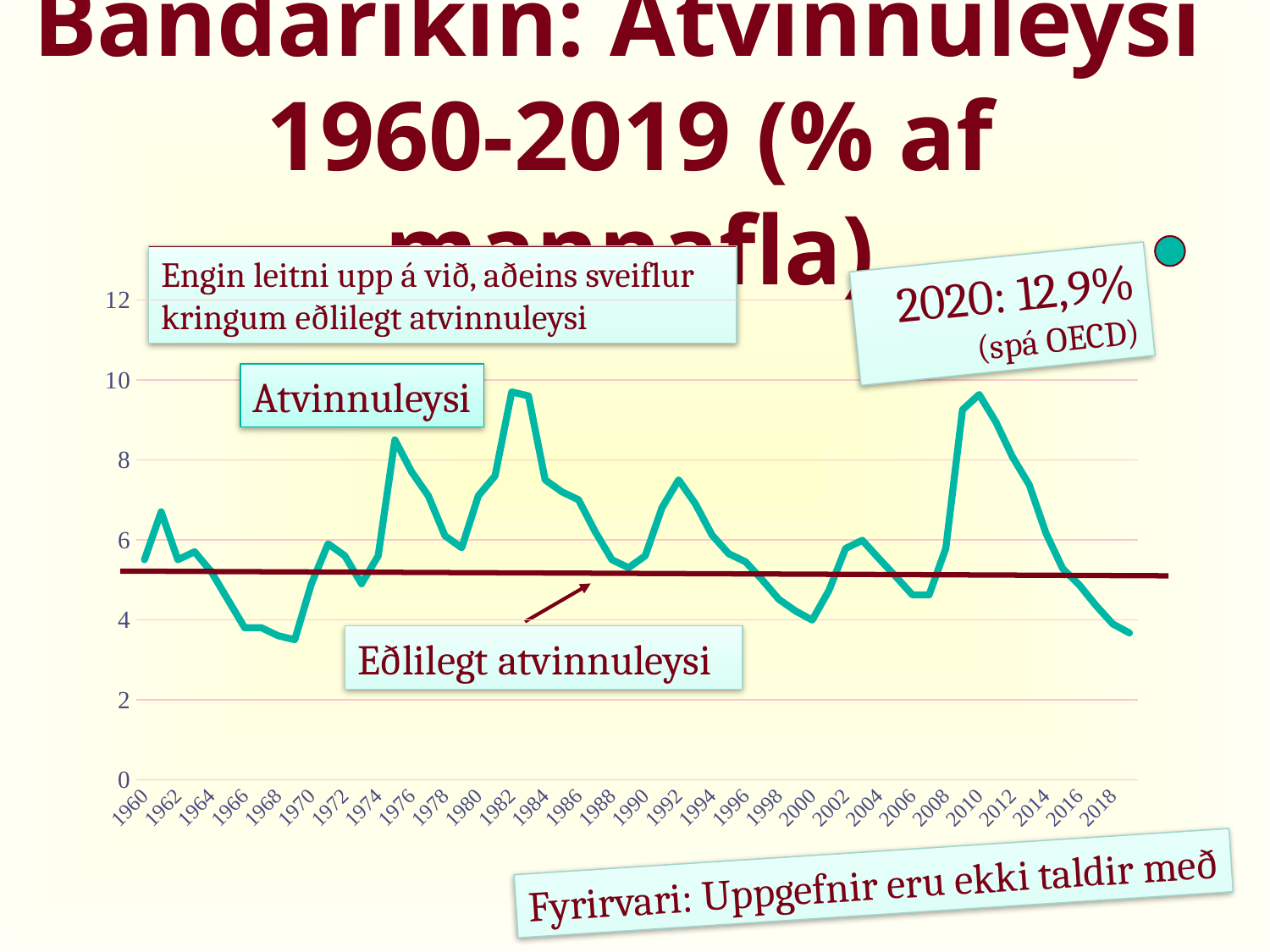
What is the title of the chart on the slide? Bandaríkin: Atvinnuleysi 1960-2019 (% af mannafla) What is the highest value shown on the vertical axis? 12 What kind of chart is shown on the slide? line chart Which year has the higher unemployment value, 1975 or 1969? 1975 What does the flat horizontal line across the chart represent, according to its label? Eðlilegt atvinnuleysi What unemployment rate is given for 2020 in the annotation on the slide? 12,9% Is the unemployment value for 2010 greater or less than 8? greater Which year has the higher unemployment value, 1982 or 2000? 1982 Does the unemployment line rise or fall between 2010 and 2018? fall Is the unemployment value for 1982 greater or less than 8? greater Is the unemployment value for 2018 greater or less than 6? less